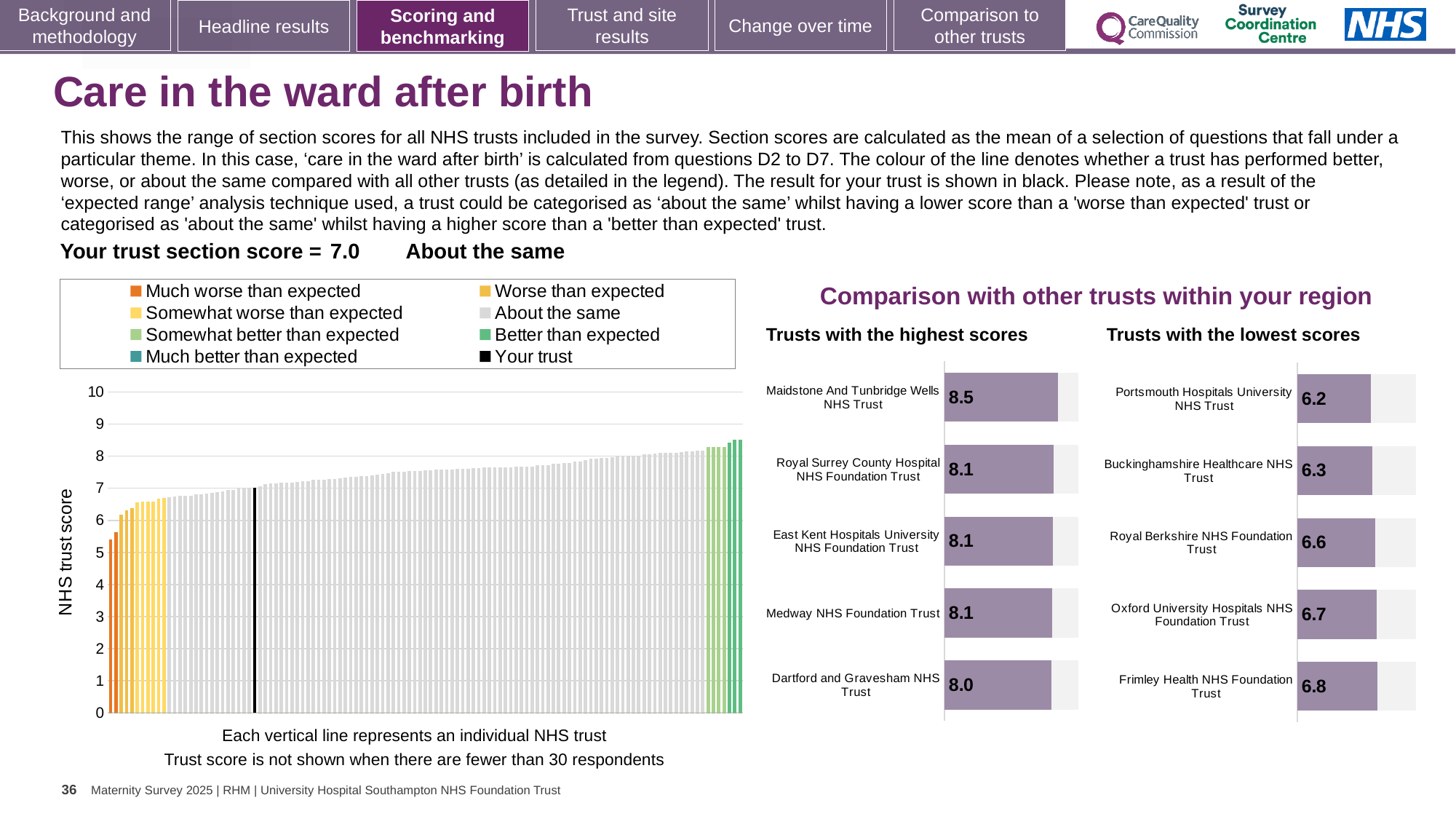
In the 'Trusts with the lowest scores' chart, what is the score for Royal Berkshire NHS Foundation Trust? 6.6 In the main chart on the left, do the trust scores rise or fall from left to right? Rise How many entries does the legend above the main chart on the left list? 8 In the 'Trusts with the lowest scores' chart, which trust has the lowest score? Portsmouth Hospitals University NHS Trust In the 'Trusts with the lowest scores' chart, what is the difference between the scores of Frimley Health NHS Foundation Trust and Portsmouth Hospitals University NHS Trust? 0.6 In the 'Trusts with the highest scores' chart, which trust has the highest score? Maidstone And Tunbridge Wells NHS Trust In the main chart on the left, what is the section score for your trust (the black bar)? 7.0 In the 'Trusts with the highest scores' chart, what is the score for Maidstone And Tunbridge Wells NHS Trust? 8.5 What kind of chart is the main chart on the left showing the range of NHS trust scores? Bar chart In the 'Trusts with the lowest scores' chart, which has the higher score: Buckinghamshire Healthcare NHS Trust or Oxford University Hospitals NHS Foundation Trust? Oxford University Hospitals NHS Foundation Trust In the 'Trusts with the highest scores' chart, what is the difference between the scores of Maidstone And Tunbridge Wells NHS Trust and Dartford and Gravesham NHS Trust? 0.5 How many trusts are shown in the 'Trusts with the highest scores' chart? 5